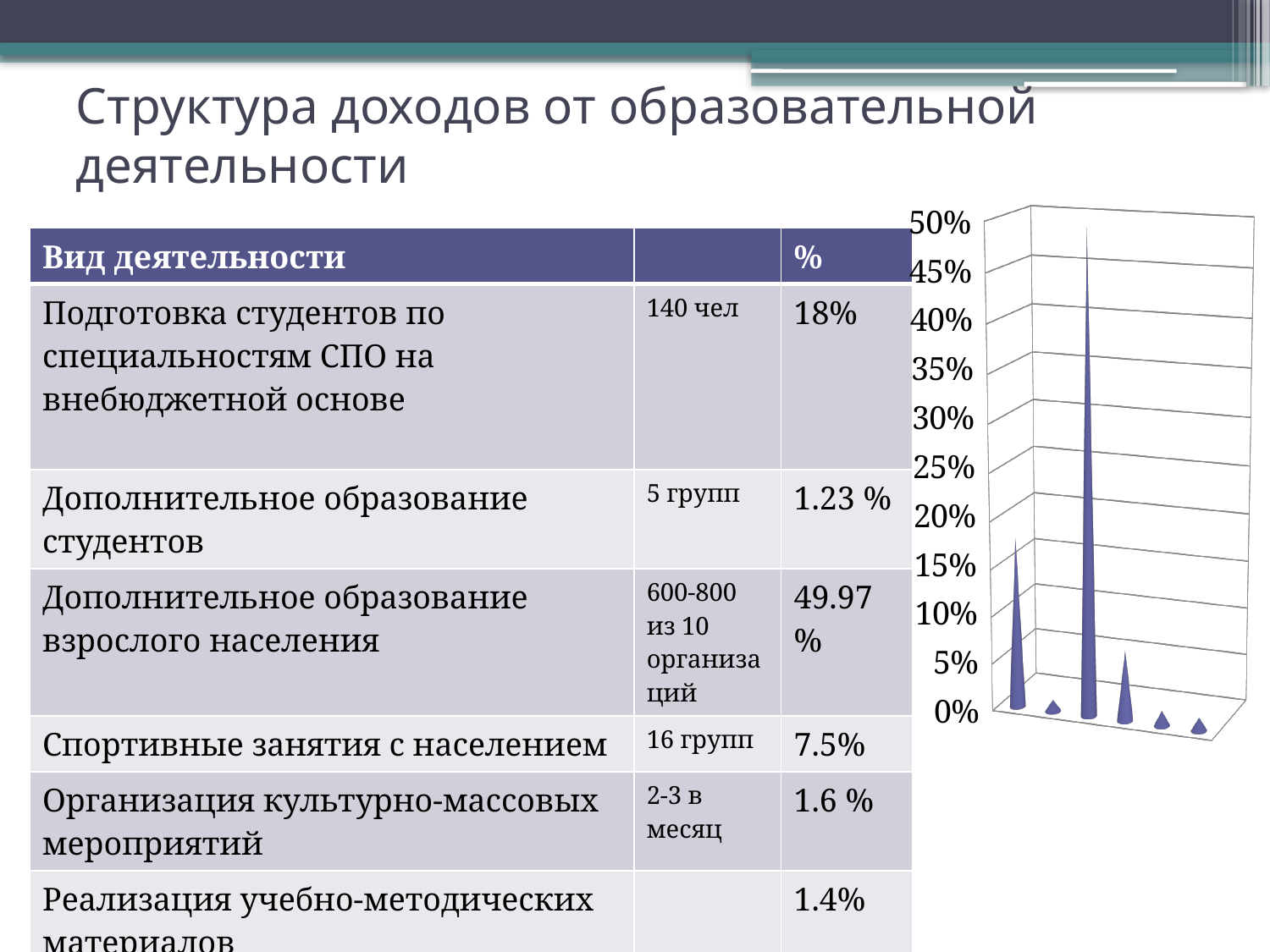
Which cone in the chart is the tallest? the third from the left What is the interval between tick marks on the chart's vertical axis? 5% Which is taller in the chart: the first cone from the left or the fourth cone from the left? the first cone Is the value of the first (leftmost) cone in the chart greater or less than 20%? less How many data points (cones) are plotted in the chart? 6 Is the value of the first (leftmost) cone in the chart greater or less than 10%? greater What kind of chart is shown on the right of the slide? bar chart What is the highest value shown on the chart's vertical axis? 50% Is the value of the second cone from the left in the chart greater or less than 25%? less